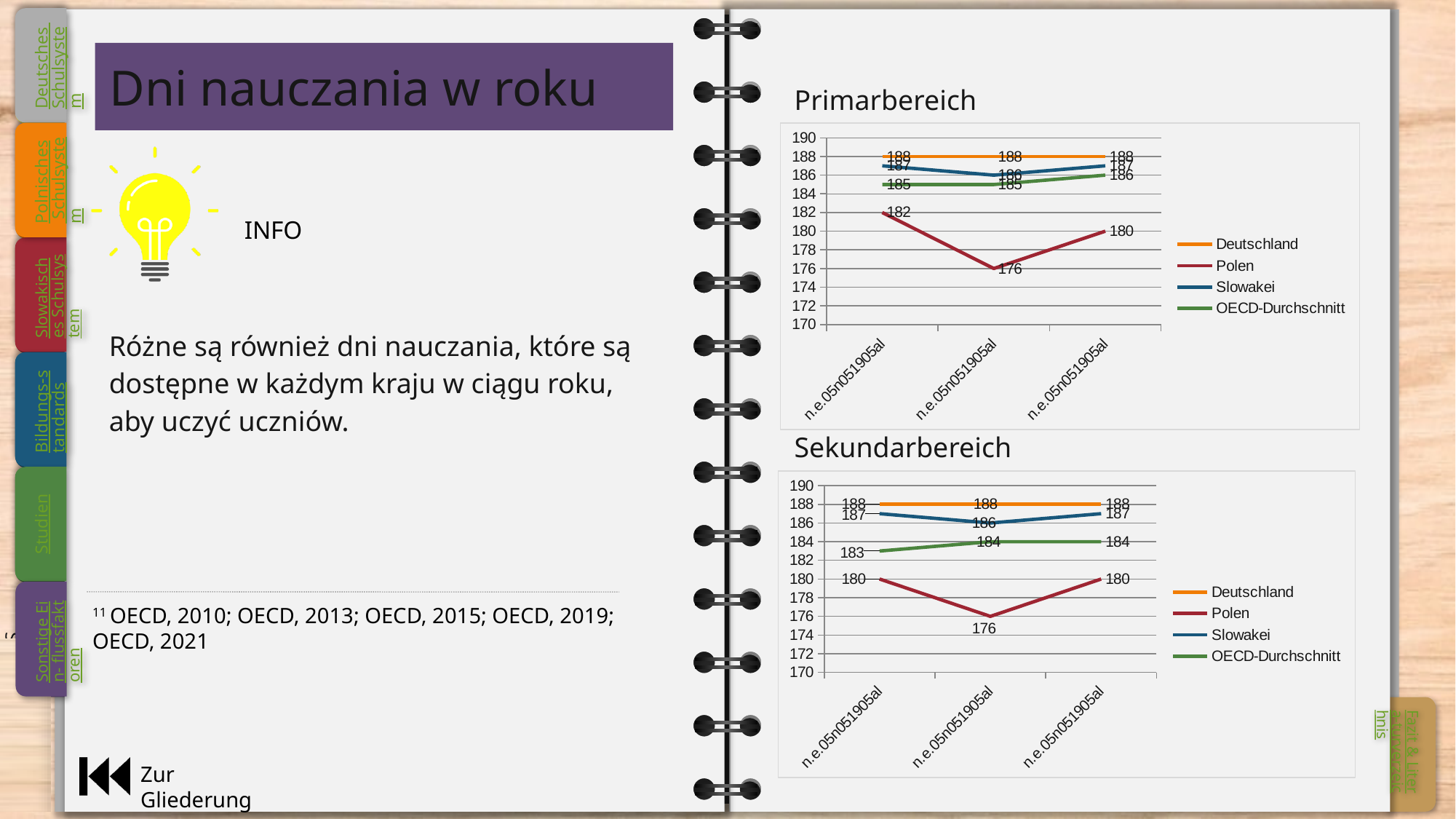
In the Sekundarbereich chart, does the Polen line fall or rise from the first to the middle data point? fall In the Primarbereich chart, which series has the lowest value at the middle data point? Polen How many data points does each series in the Sekundarbereich chart have? 3 How many series does the legend of the Sekundarbereich chart list? 4 What kind of chart is the Primarbereich chart? line chart In the Sekundarbereich chart, what is the difference between Slowakei and OECD-Durchschnitt at the first data point? 4 In the Primarbereich chart, what is the difference between Deutschland and Polen at the middle data point? 12 In the Primarbereich chart, what colour is the Deutschland line? orange In the Primarbereich chart, what is the value of Polen at the middle data point? 176 In the Sekundarbereich chart, which series has the highest value at the last data point? Deutschland In the Primarbereich chart, which is larger at the first data point: Slowakei or OECD-Durchschnitt? Slowakei In the Sekundarbereich chart, what is the value of OECD-Durchschnitt at the first data point? 183